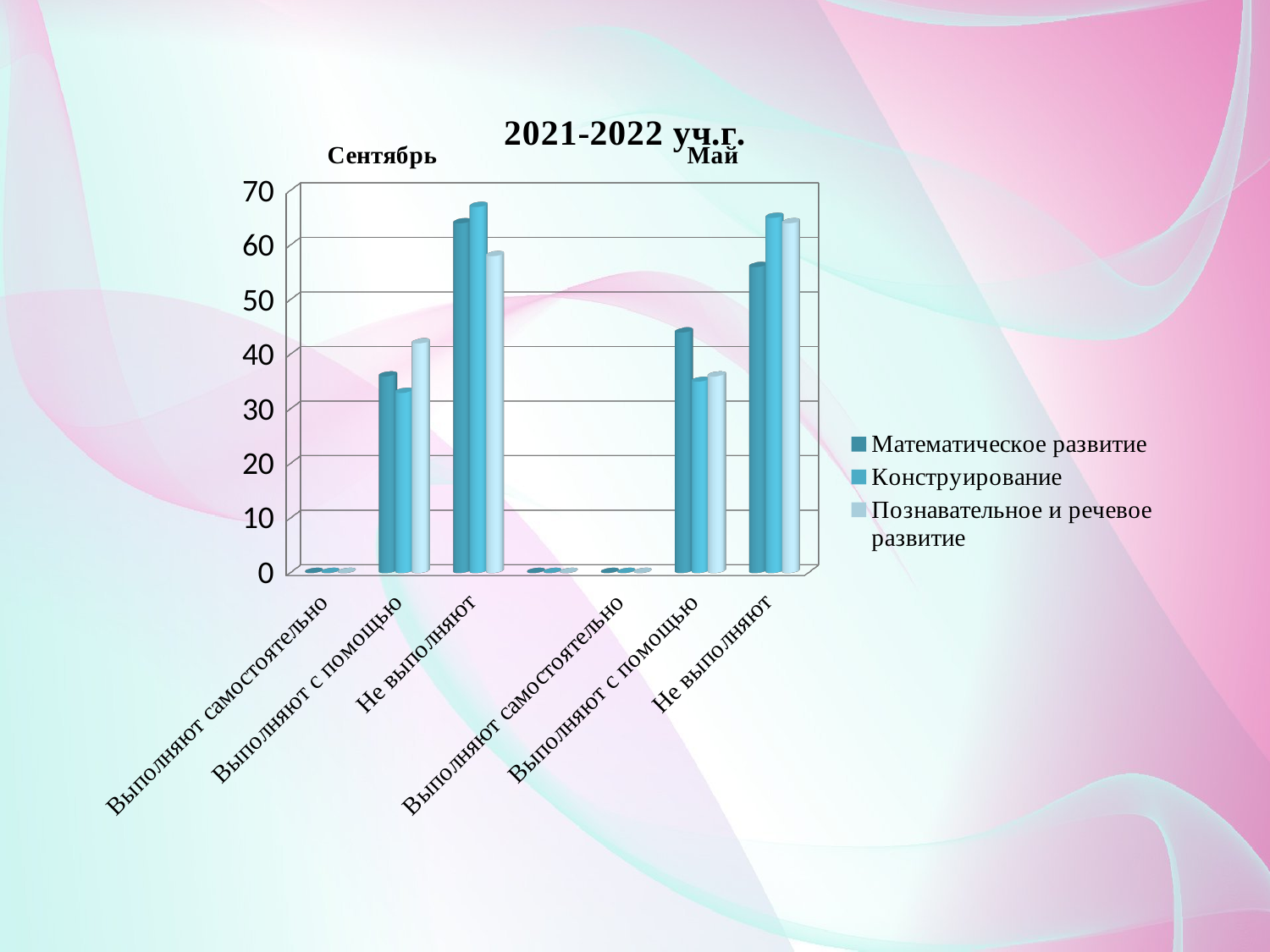
Is the value for Конструирование in the Сентябрь 'Выполняют с помощью' category greater or less than 40? less What kind of chart is shown on the slide? bar chart Is the value for Математическое развитие in the Сентябрь 'Не выполняют' category greater or less than 60? greater For Математическое развитие in the 'Выполняют с помощью' category, which is larger: the Сентябрь value or the Май value? Май Which series has the highest value in the Сентябрь 'Не выполняют' category? Конструирование Which series has the lowest value in the Май 'Не выполняют' category? Математическое развитие How many series does the legend list? 3 Is the value for Математическое развитие in the Май 'Выполняют с помощью' category greater or less than 40? greater What is the title of the chart? 2021-2022 уч.г. Which series is listed second in the legend? Конструирование How many categories are shown along the x axis? 6